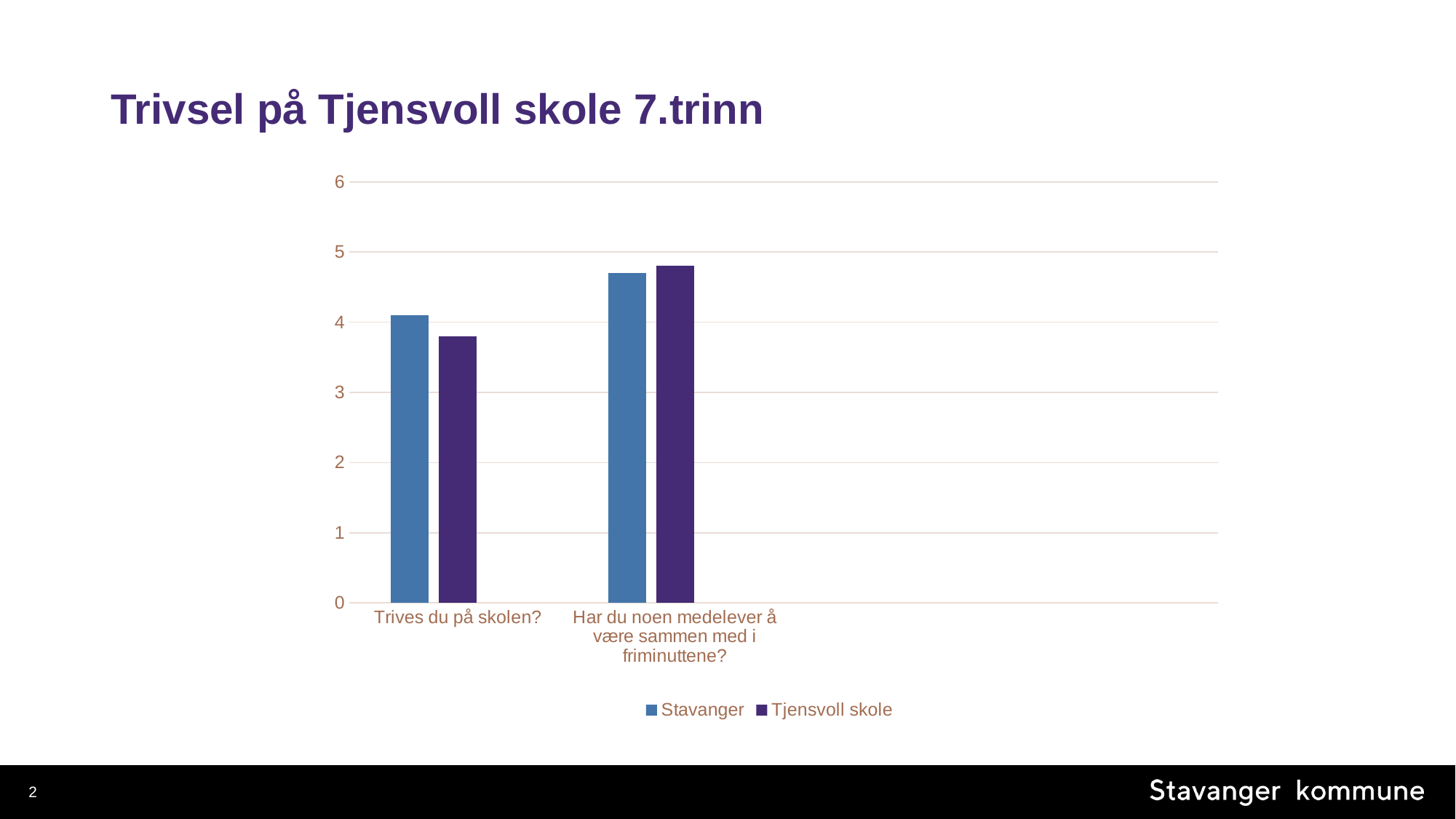
For the Stavanger series, which category has the higher value? Har du noen medelever å være sammen med i friminuttene? Is the value for Tjensvoll skole on "Trives du på skolen?" greater or less than 4? less How many categories are shown on the x axis? 2 Is the value for Stavanger on "Trives du på skolen?" greater or less than 5? less What kind of chart is shown on the slide? bar chart For "Trives du på skolen?", which series has the larger value, Stavanger or Tjensvoll skole? Stavanger Is the value for Tjensvoll skole on "Har du noen medelever å være sammen med i friminuttene?" greater or less than 5? less Which bar in the chart is the lowest? Tjensvoll skole for "Trives du på skolen?" What is the title of the slide containing the chart? Trivsel på Tjensvoll skole 7.trinn How many series does the legend list? 2 Which two series are listed in the legend? Stavanger and Tjensvoll skole